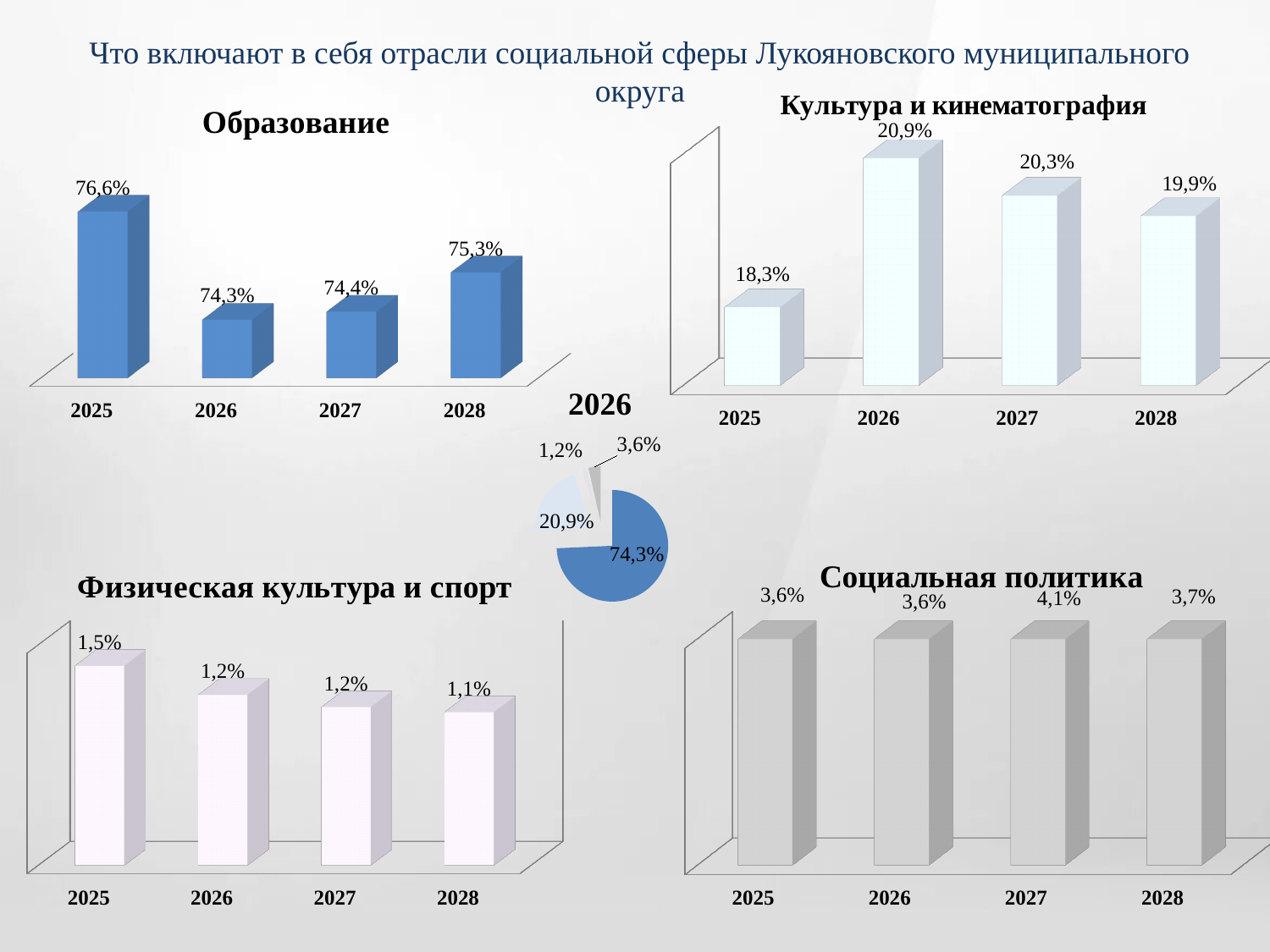
In the Образование chart, what is the value for 2025? 76,6% In the Культура и кинематография chart, which is larger, the value for 2027 or for 2028? 2027 What kind of chart is the Социальная политика chart? bar chart In the Физическая культура и спорт chart, do the values rise or fall from 2025 to 2028? fall In the Социальная политика chart, which year has the highest value? 2027 In the Образование chart, what is the difference between the values for 2025 and 2026? 2,3% In the pie chart titled 2026, what is the value of the largest slice? 74,3% In the Культура и кинематография chart, what is the difference between the values for 2026 and 2025? 2,6% In the Культура и кинематография chart, which year has the highest value? 2026 In the Социальная политика chart, what is the value for 2027? 4,1% In the Физическая культура и спорт chart, what is the value for 2028? 1,1% How many years are shown in the Культура и кинематография chart? 4